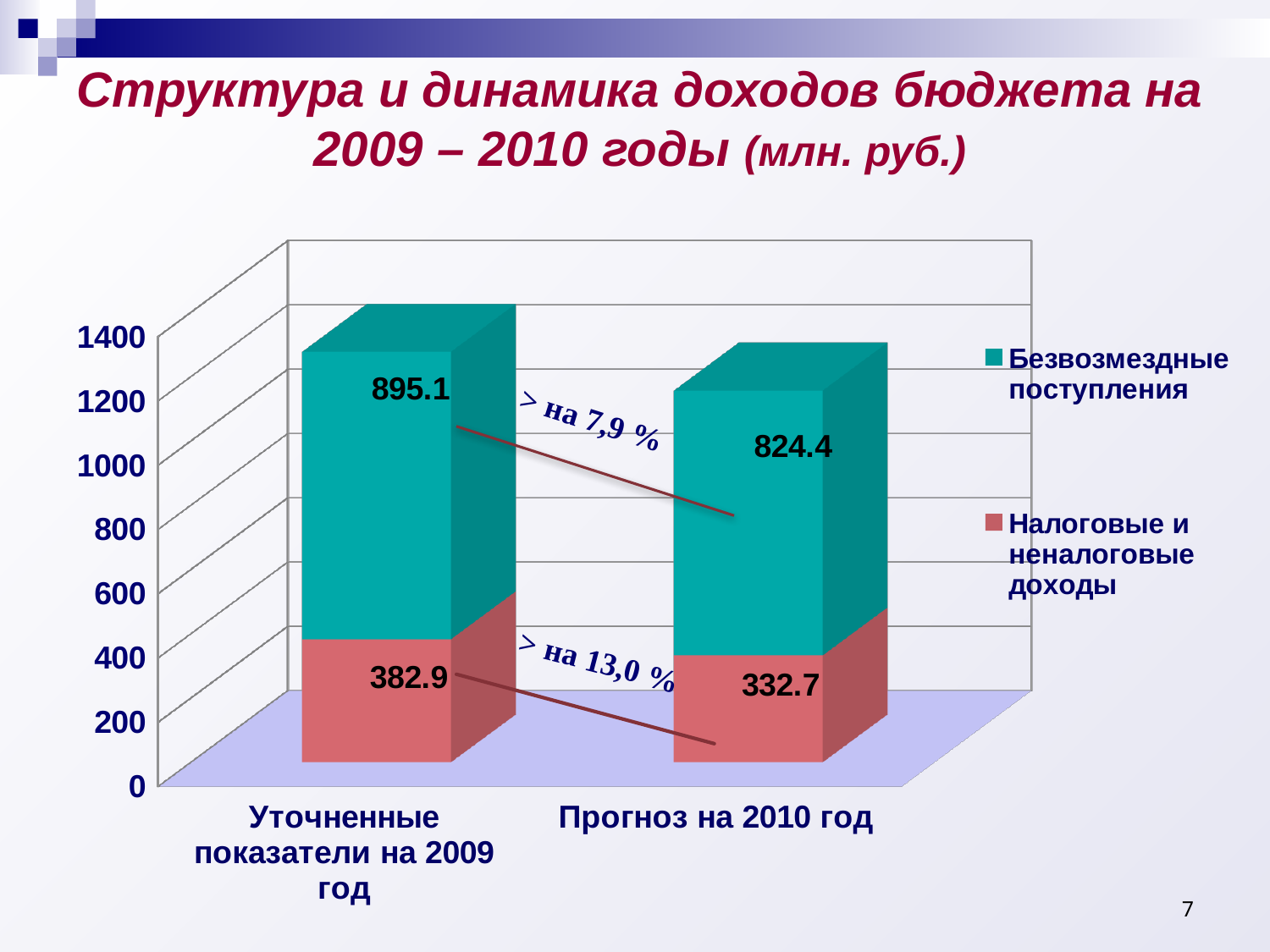
What is the value of Налоговые и неналоговые доходы for Уточненные показатели на 2009 год? 382.9 Which category has the larger value for Безвозмездные поступления? Уточненные показатели на 2009 год What is the difference between the Налоговые и неналоговые доходы values for 2009 and 2010? 50.2 What kind of chart is shown on the slide? Stacked bar chart How many series does the legend list? 2 How many categories are shown on the x axis? 2 What is the value of Безвозмездные поступления for Уточненные показатели на 2009 год? 895.1 What is the total of the stacked bar for Прогноз на 2010 год? 1157.1 What is the value of Безвозмездные поступления for Прогноз на 2010 год? 824.4 What is the difference between the Безвозмездные поступления values for 2009 and 2010? 70.7 What is the value of Налоговые и неналоговые доходы for Прогноз на 2010 год? 332.7 What is the total of the stacked bar for Уточненные показатели на 2009 год? 1278